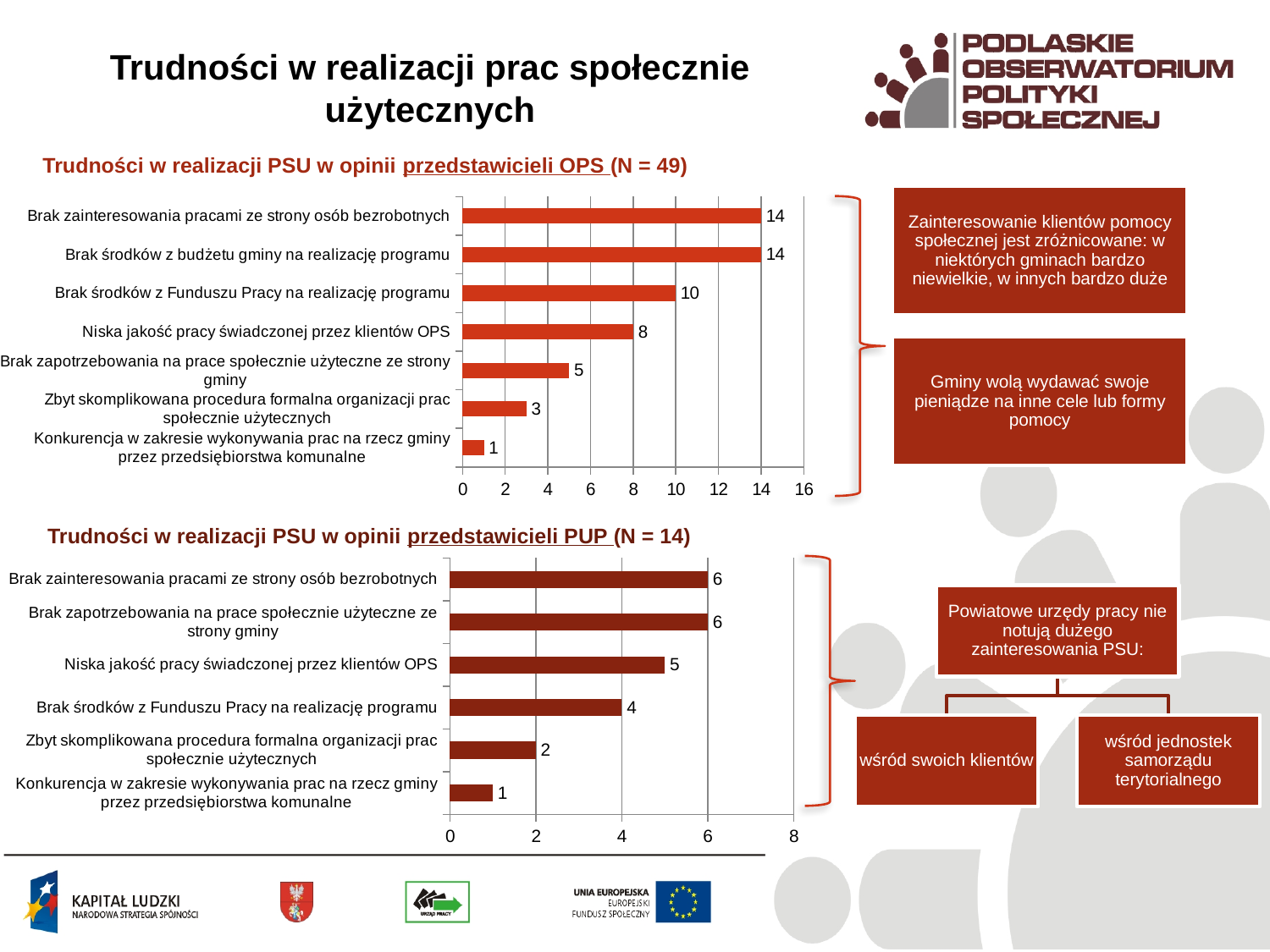
How many categories are plotted in the top chart (przedstawiciele OPS, N = 49)? 7 How many categories are plotted in the bottom chart (przedstawiciele PUP, N = 14)? 6 What type of chart is the top chart (przedstawiciele OPS, N = 49)? Bar chart In the bottom chart (przedstawiciele PUP, N = 14), what value is shown for 'Niska jakość pracy świadczonej przez klientów OPS'? 5 In the bottom chart (przedstawiciele PUP, N = 14), what is the difference between 'Brak zainteresowania pracami ze strony osób bezrobotnych' and 'Konkurencja w zakresie wykonywania prac na rzecz gminy przez przedsiębiorstwa komunalne'? 5 In the top chart (przedstawiciele OPS, N = 49), what is the difference between 'Brak zainteresowania pracami ze strony osób bezrobotnych' and 'Zbyt skomplikowana procedura formalna organizacji prac społecznie użytecznych'? 11 In the top chart (przedstawiciele OPS, N = 49), which category has the lowest value? Konkurencja w zakresie wykonywania prac na rzecz gminy przez przedsiębiorstwa komunalne In the top chart (przedstawiciele OPS, N = 49), what value is shown for 'Brak środków z Funduszu Pracy na realizację programu'? 10 In the bottom chart (przedstawiciele PUP, N = 14), which is larger: 'Brak środków z Funduszu Pracy na realizację programu' or 'Niska jakość pracy świadczonej przez klientów OPS'? Niska jakość pracy świadczonej przez klientów OPS In the bottom chart (przedstawiciele PUP, N = 14), what value is shown for 'Zbyt skomplikowana procedura formalna organizacji prac społecznie użytecznych'? 2 What is the maximum value shown on the x axis of the bottom chart (przedstawiciele PUP, N = 14)? 8 In the top chart (przedstawiciele OPS, N = 49), what value is shown for 'Niska jakość pracy świadczonej przez klientów OPS'? 8